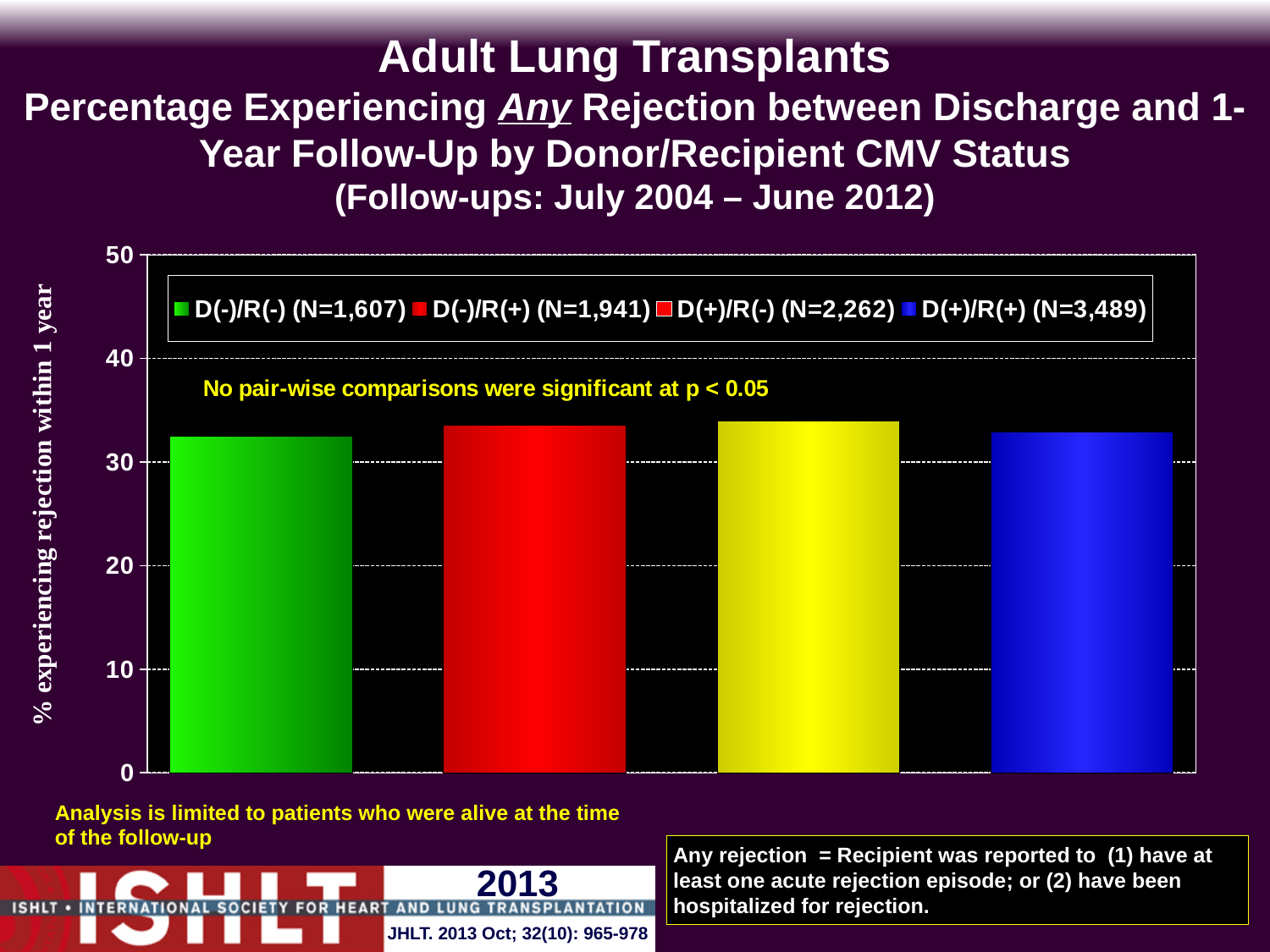
Is the value for D(-)/R(+) (N=1,941) greater or less than 40? less What is the N for the D(+)/R(+) group in the legend? 3,489 What is the N for the D(-)/R(+) group in the legend? 1,941 Is the value for D(+)/R(+) (N=3,489) greater or less than 20? greater Is the value for D(+)/R(-) (N=2,262) greater or less than 30? greater What is the label on the y axis of the chart? % experiencing rejection within 1 year What kind of chart is shown on the slide? bar chart How many bars are plotted in the chart? 4 How many series does the legend list? 4 What is the maximum value shown on the y axis? 50